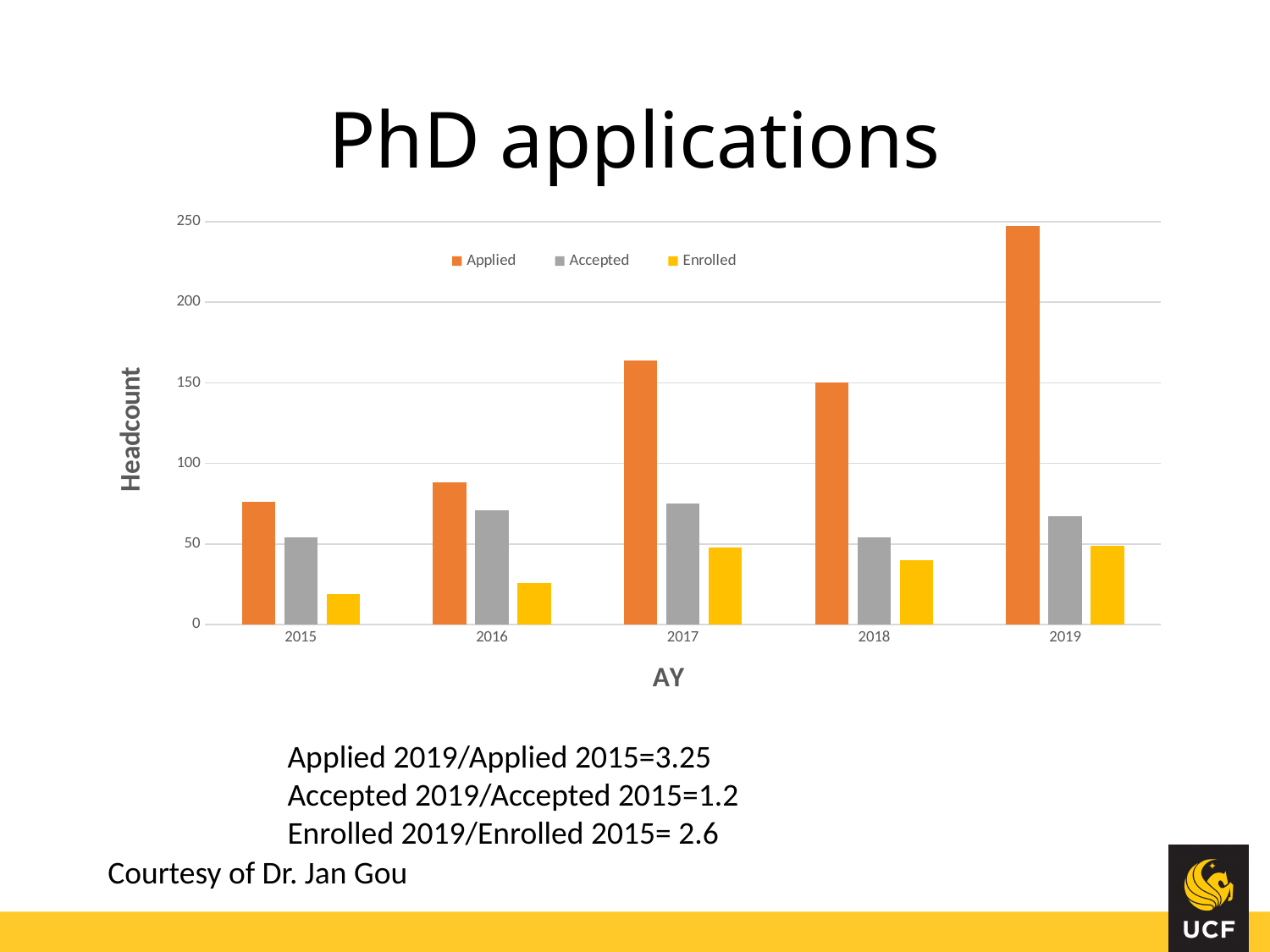
Which year has the larger Accepted value, 2015 or 2016? 2016 In which year is the Enrolled value lowest? 2015 What is the title of the vertical axis? Headcount Is the Applied value for 2015 greater or less than 100? less Does the Applied value rise or fall from 2015 to 2017? rise How many academic years are shown on the x axis? 5 Is the Applied value for 2019 greater or less than 200? greater Which year has the larger Applied value, 2016 or 2017? 2017 Is the Enrolled value for 2015 greater or less than 50? less What kind of chart is shown on the slide? bar chart How many series does the legend list? 3 In which year is the Applied value highest? 2019